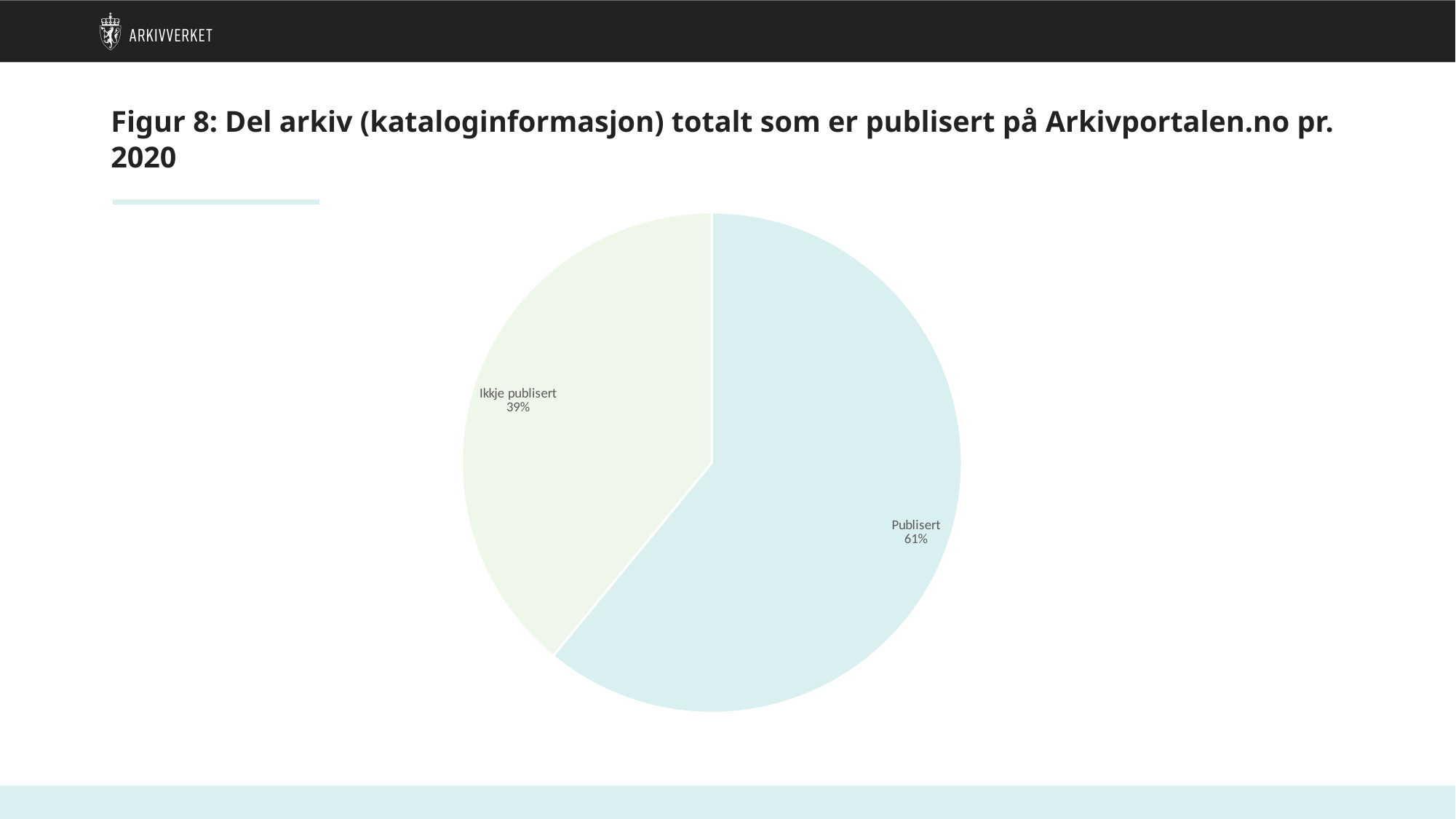
What share of the pie is labelled Ikkje publisert? 39% Which slice of the pie is the smallest? Ikkje publisert What is the figure number given in the slide title? Figur 8 What year does the slide title say the data is as of? 2020 Is the share for Publisert greater or less than 50%? greater What is the difference in percentage points between the Publisert and Ikkje publisert slices? 22 What kind of chart is shown on the slide? pie chart Which slice of the pie is the largest? Publisert What share of the pie is labelled Publisert? 61% Which is larger, the Publisert slice or the Ikkje publisert slice? Publisert Is the share for Ikkje publisert greater or less than 50%? less How many slices does the pie chart have? 2